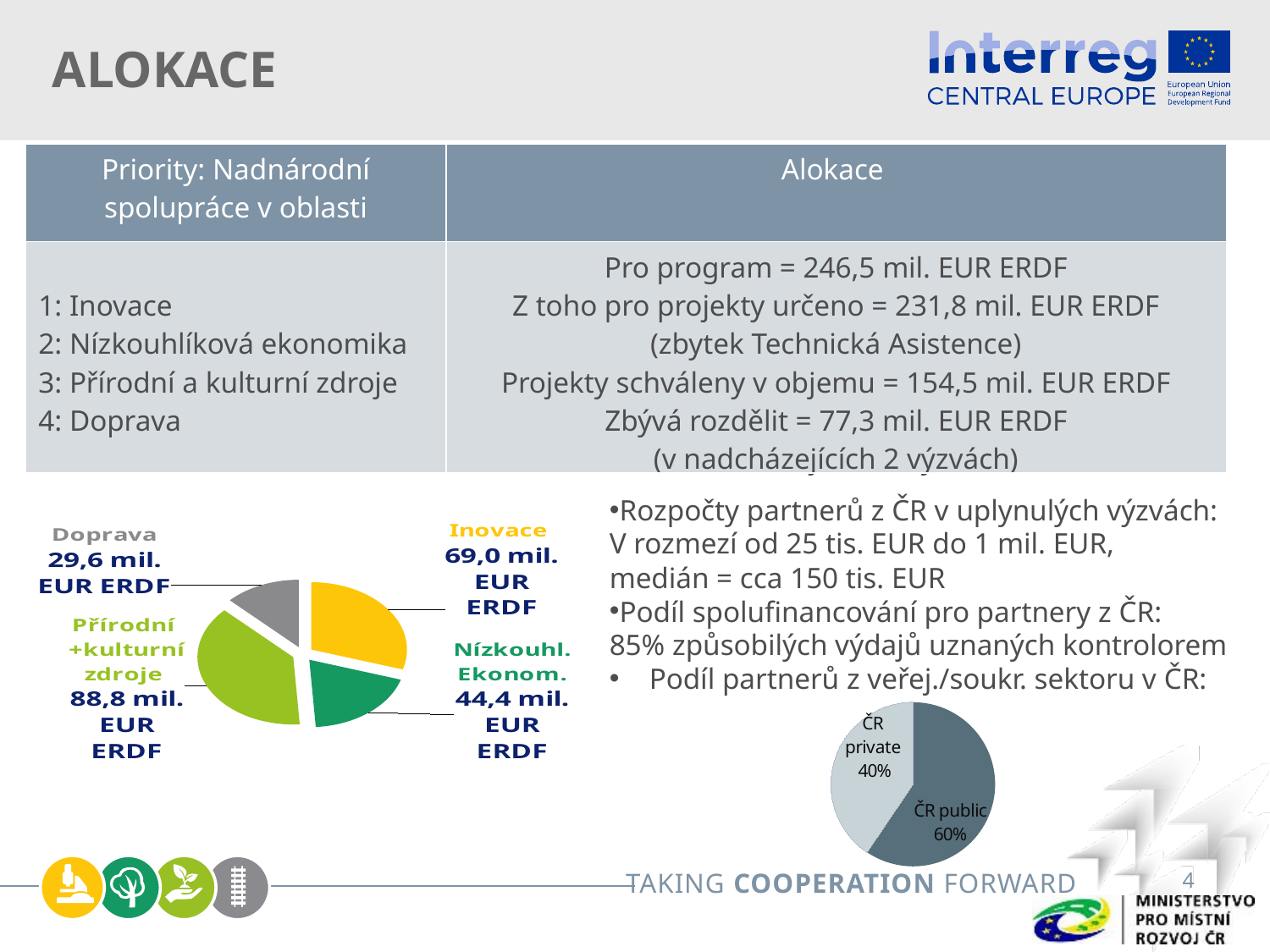
In the bottom-right pie chart, what share does ČR public have? 60% How many slices does the left pie chart have? 4 In the left pie chart, which category has the largest value? Přírodní +kulturní zdroje What kind of chart is the chart at the bottom left of the slide? Pie chart In the bottom-right pie chart, what share does ČR private have? 40% In the left pie chart, which category has the smallest value? Doprava In the left pie chart, which is larger: Inovace or Doprava? Inovace In the left pie chart, what is the value for Inovace? 69,0 mil. EUR ERDF In the left pie chart, what is the value for Přírodní +kulturní zdroje? 88,8 mil. EUR ERDF In the left pie chart, what is the difference between the values for Inovace and Nízkouhl. Ekonom.? 24,6 mil. EUR ERDF In the left pie chart, what is the value for Doprava? 29,6 mil. EUR ERDF In the bottom-right pie chart, which slice is larger: ČR public or ČR private? ČR public